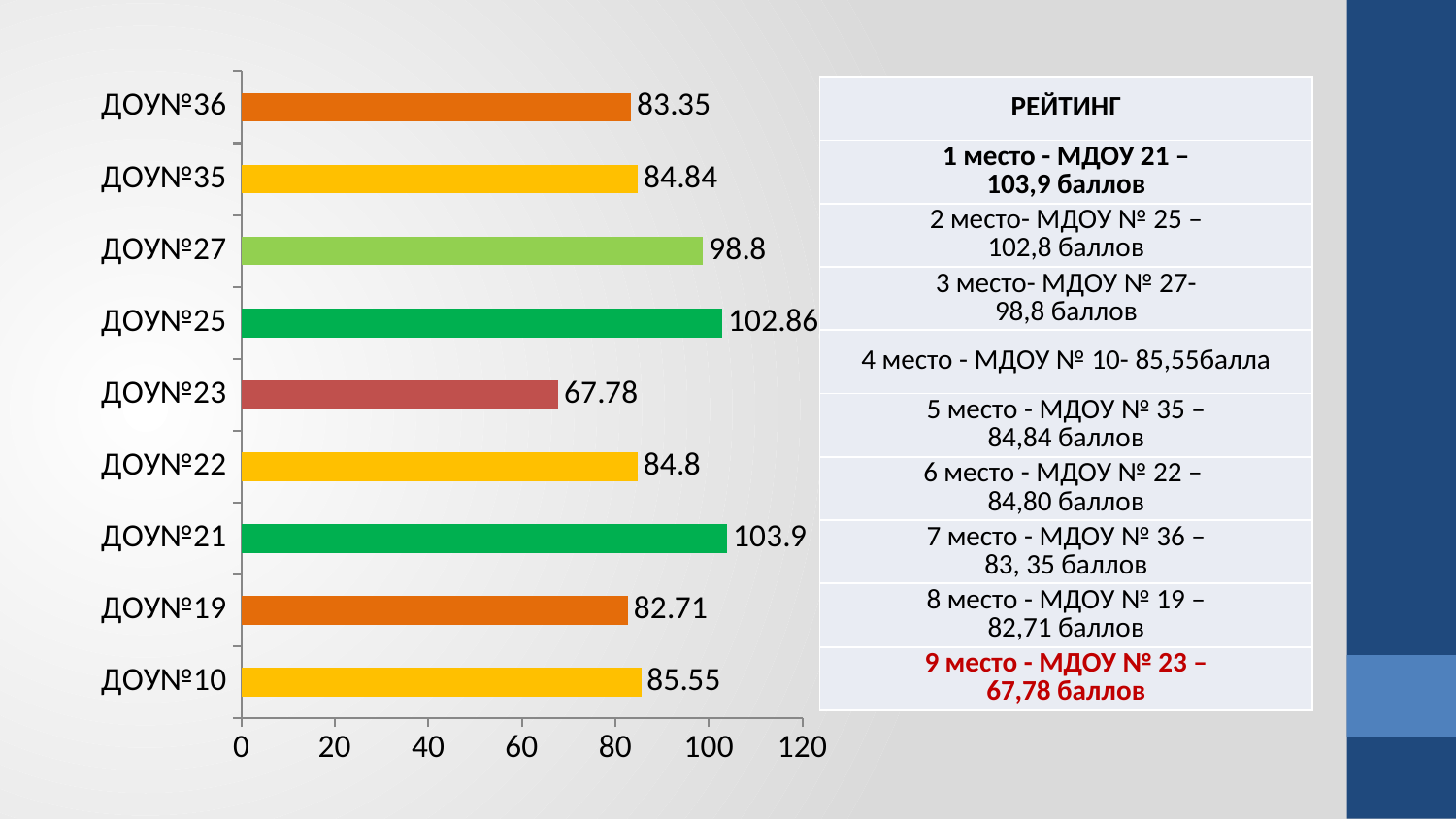
What is the value for ДОУ№27? 98.8 Is the value for ДОУ№25 greater or less than 100? greater What is the difference between the values for ДОУ№25 and ДОУ№27? 4.06 Which category has the highest value? ДОУ№21 Is the value for ДОУ№23 greater or less than 80? less What is the difference between the values for ДОУ№21 and ДОУ№23? 36.12 What is the value for ДОУ№10? 85.55 Which is larger, the value for ДОУ№36 or the value for ДОУ№19? ДОУ№36 Which category has the lowest value? ДОУ№23 What kind of chart is shown on the slide? bar chart What is the value for ДОУ№23? 67.78 How many categories are shown in the chart? 9